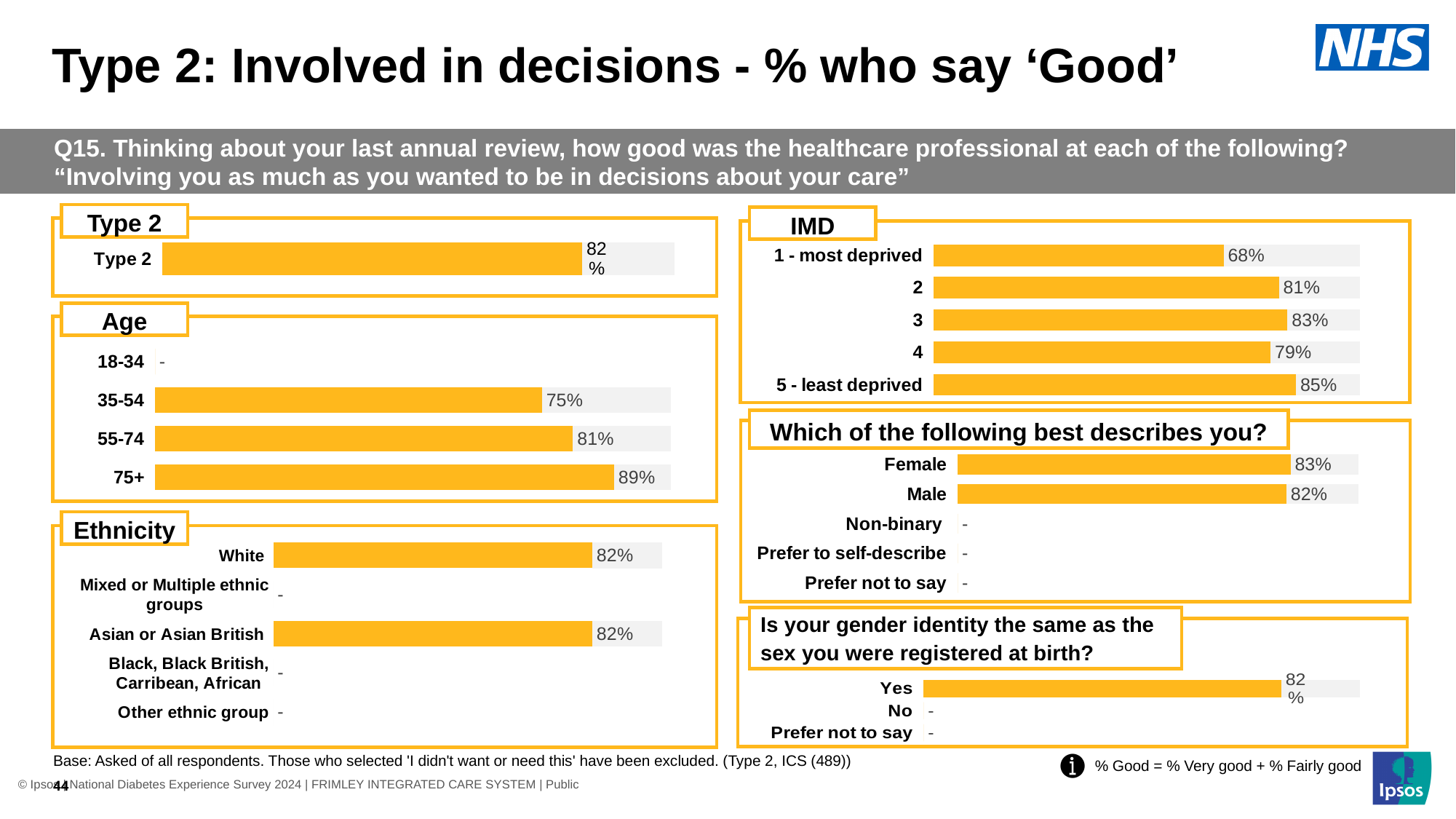
In the Age chart, do the values rise or fall from 35-54 to 75+? Rise In the Age chart, what is the value for 75+? 89% In the IMD chart, what is the value for 1 - most deprived? 68% In the 'Which of the following best describes you?' chart, which is larger, the value for Female or the value for Male? Female In the IMD chart, what is the difference between the values for 5 - least deprived and 1 - most deprived? 17 percentage points In the 'Is your gender identity the same as the sex you were registered at birth?' chart, what is the value for Yes? 82% In the IMD chart, which category has the highest value? 5 - least deprived In the IMD chart, which category has the lowest value? 1 - most deprived In the Age chart, what is the difference between the values for 75+ and 35-54? 14 percentage points How many categories are listed in the IMD chart? 5 In the Ethnicity chart, what is the value for Asian or Asian British? 82% What kind of chart is the Age chart? Bar chart